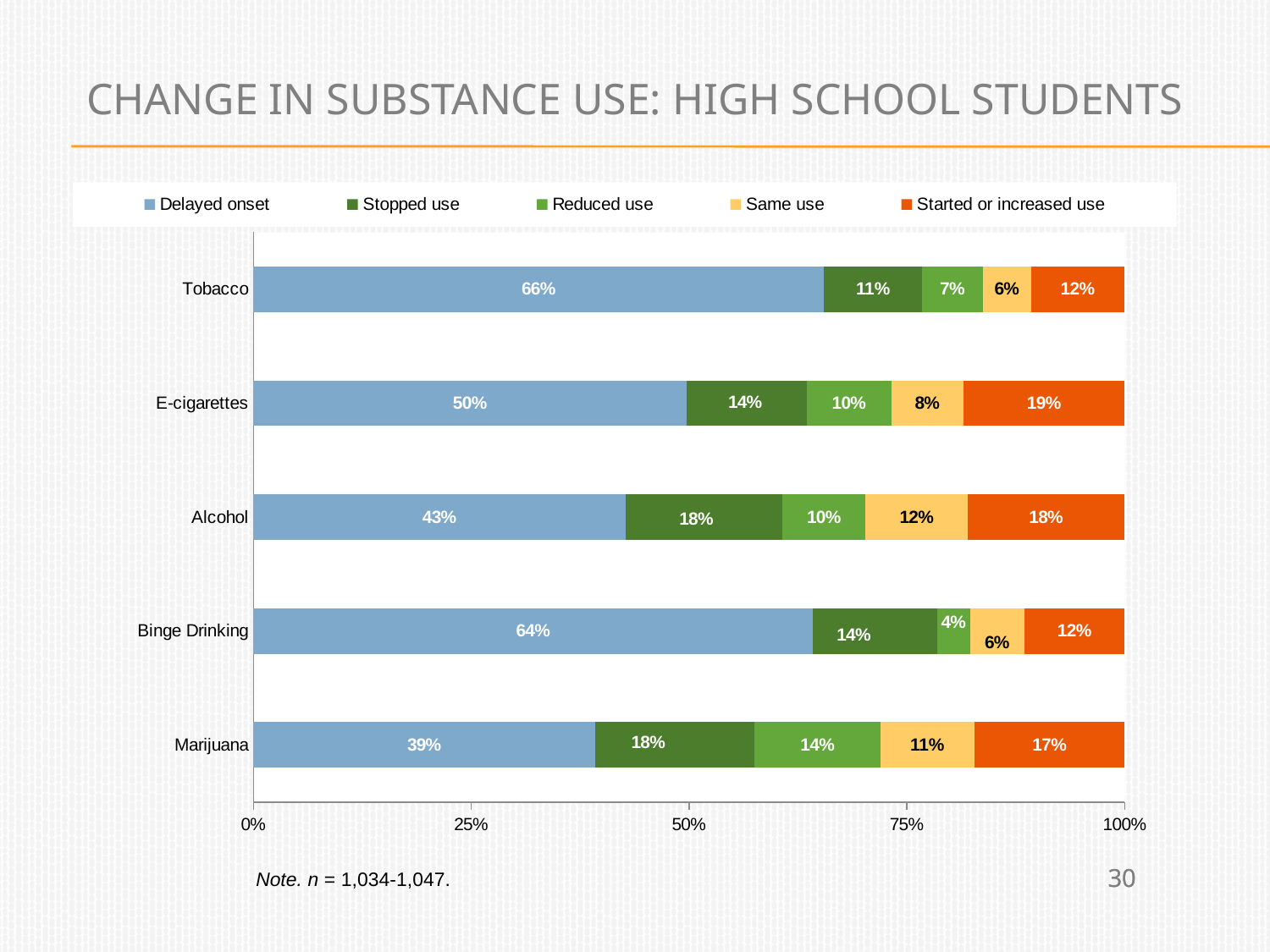
What is the total of the Binge Drinking bar? 100% Which substance has the highest Delayed onset percentage? Tobacco How many substance categories are shown in the chart? 5 Which has a larger Stopped use value, Alcohol or Tobacco? Alcohol What is the difference between the Delayed onset values for Tobacco and Marijuana? 27% What percentage of high school students reported delayed onset for Tobacco? 66% How many series does the legend list? 5 What is the Reduced use value for Binge Drinking? 4% What is the value for Started or increased use for E-cigarettes? 19% Which substance has the lowest Delayed onset percentage? Marijuana What kind of chart is shown on the slide? Stacked bar chart What is the Same use value for Alcohol? 12%